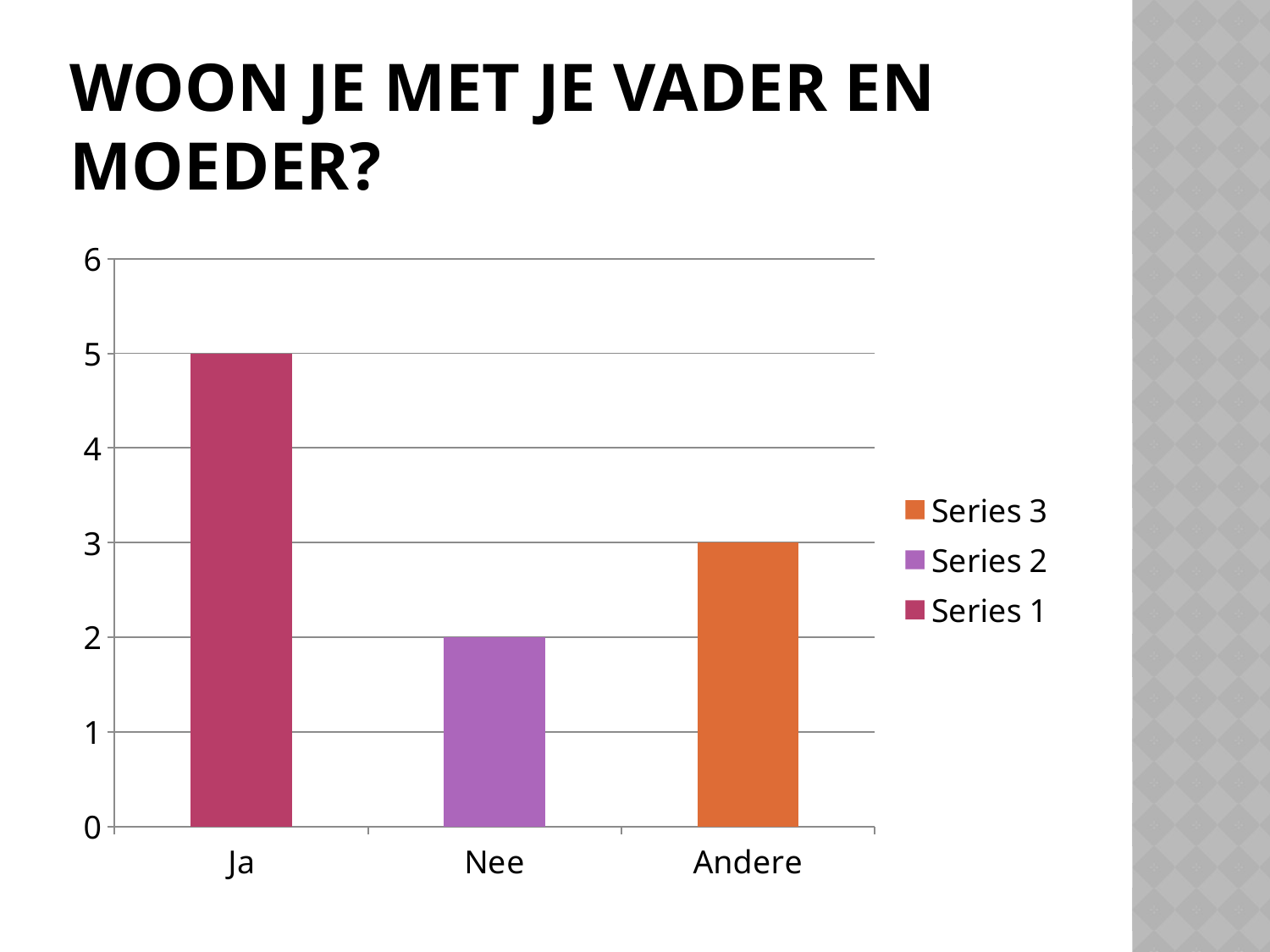
What kind of chart is shown on the slide? bar chart Which category has the lowest bar? Nee Is the value for Ja greater or less than 4? greater What is the value of the bar for Andere? 3 How many series does the legend list? 3 How many categories are shown on the x axis? 3 Which category has the highest bar? Ja What is the difference between the values for Andere and Nee? 1 What is the difference between the values for Ja and Nee? 3 What is the value of the bar for Ja? 5 What is the value of the bar for Nee? 2 Which is larger, the value for Andere or the value for Nee? Andere